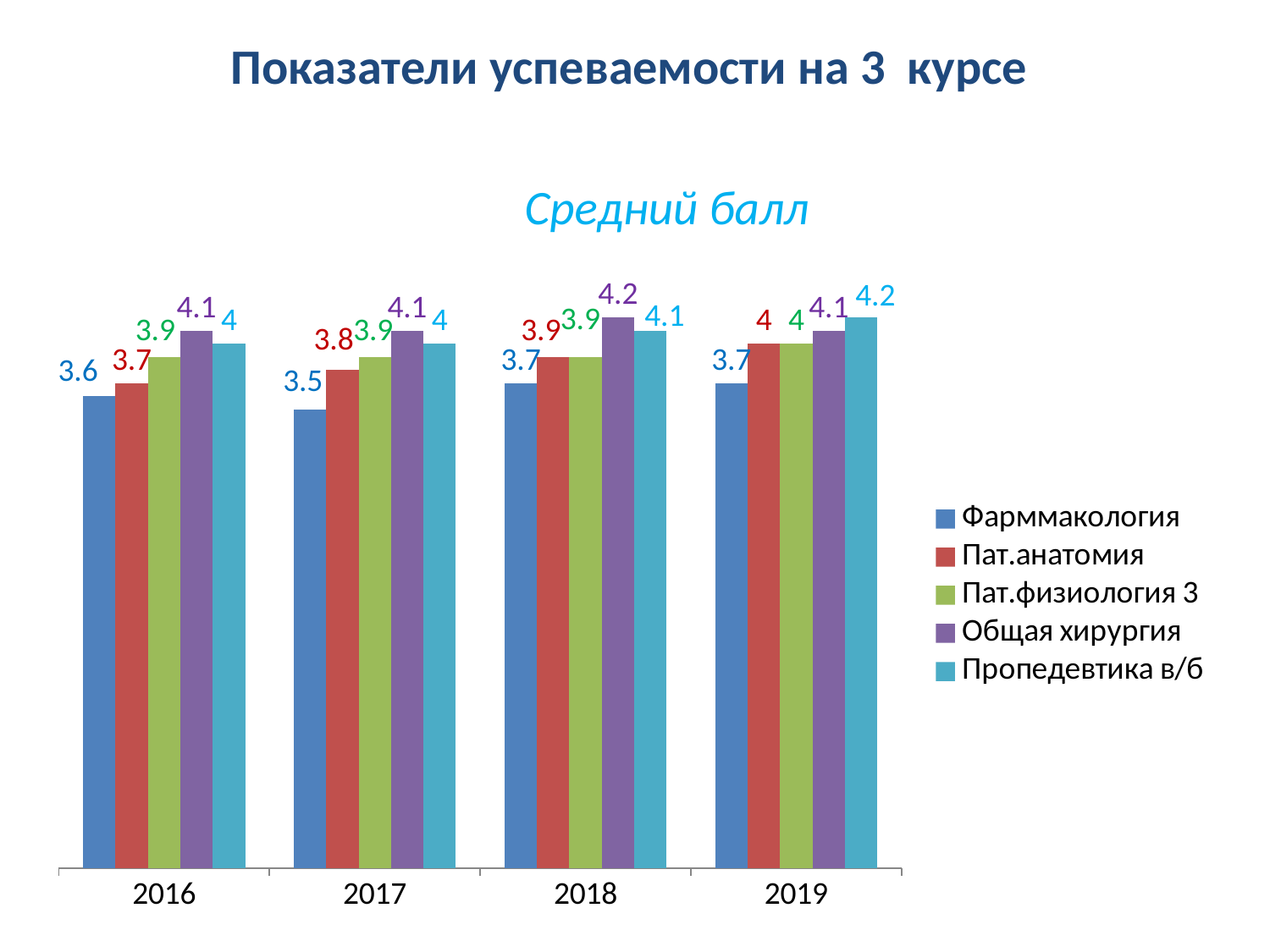
What kind of chart is shown on the slide? bar chart What is the value for Фарммакология in 2017? 3.5 What is the value for Пат.анатомия in 2016? 3.7 Which series has the highest value in 2019? Пропедевтика в/б How many series does the legend list? 5 Which series has the lowest value in 2016? Фарммакология How many years are shown on the x axis? 4 What is the value for Пропедевтика в/б in 2019? 4.2 What is the difference between Общая хирургия and Фарммакология in 2017? 0.6 Which is larger in 2018: Пат.анатомия or Фарммакология? Пат.анатомия What is the value for Общая хирургия in 2018? 4.2 What is the title of the chart? Средний балл